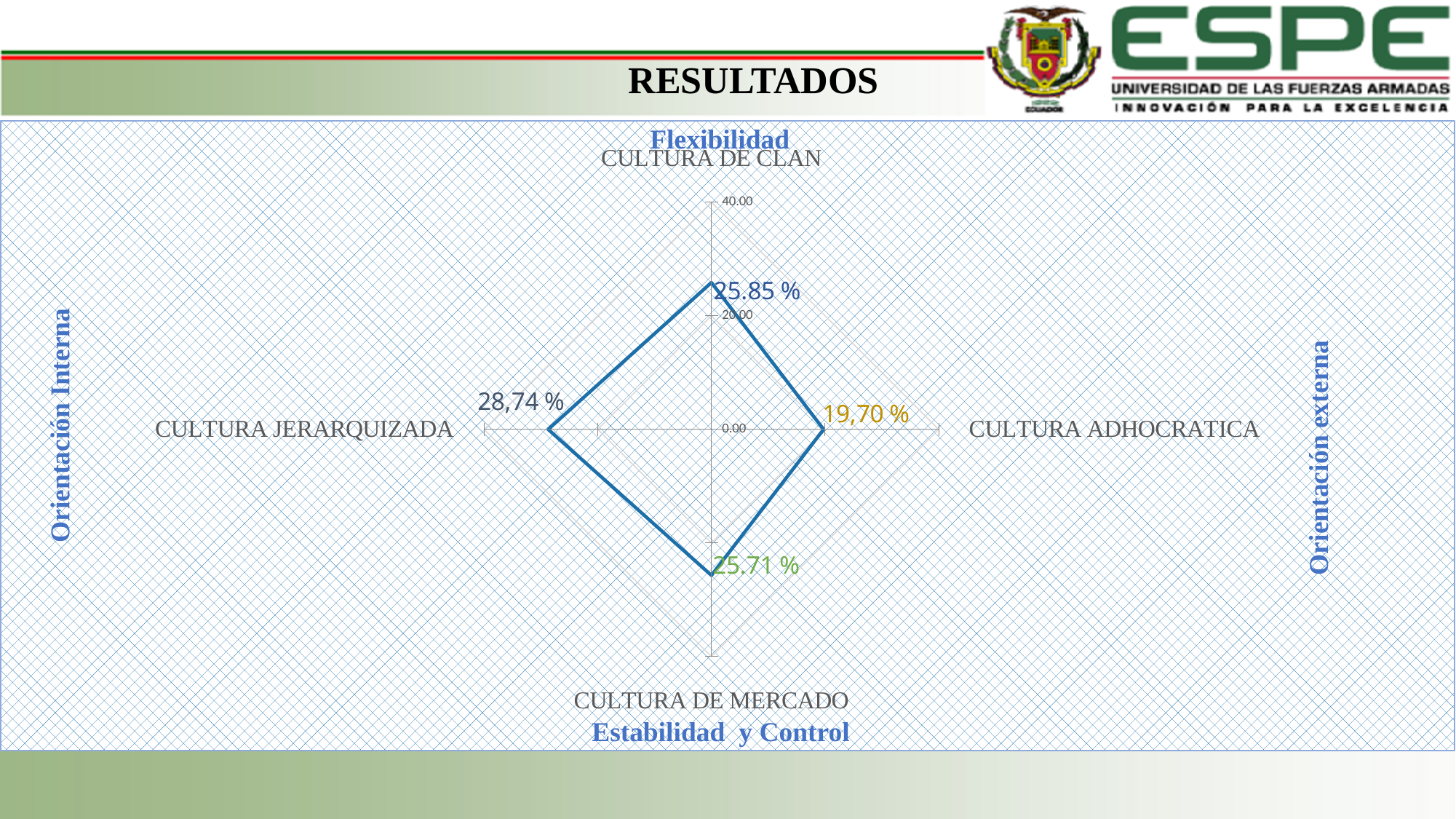
Which culture type has the lowest value on the chart? CULTURA ADHOCRATICA Which culture type has the highest value on the chart? CULTURA JERARQUIZADA What is the difference between the values for CULTURA DE CLAN and CULTURA DE MERCADO? 0.14 % What is the value shown for CULTURA ADHOCRATICA? 19,70 % Which has a larger value, CULTURA JERARQUIZADA or CULTURA ADHOCRATICA? CULTURA JERARQUIZADA What is the value shown for CULTURA DE MERCADO? 25.71 % What label appears at the top of the chart above CULTURA DE CLAN? Flexibilidad Is the value for CULTURA ADHOCRATICA greater or less than 20.00? less What type of chart is shown on the slide? Radar chart What is the value shown for CULTURA DE CLAN? 25.85 % How many culture types are plotted on the radar chart? 4 What is the value shown for CULTURA JERARQUIZADA? 28,74 %